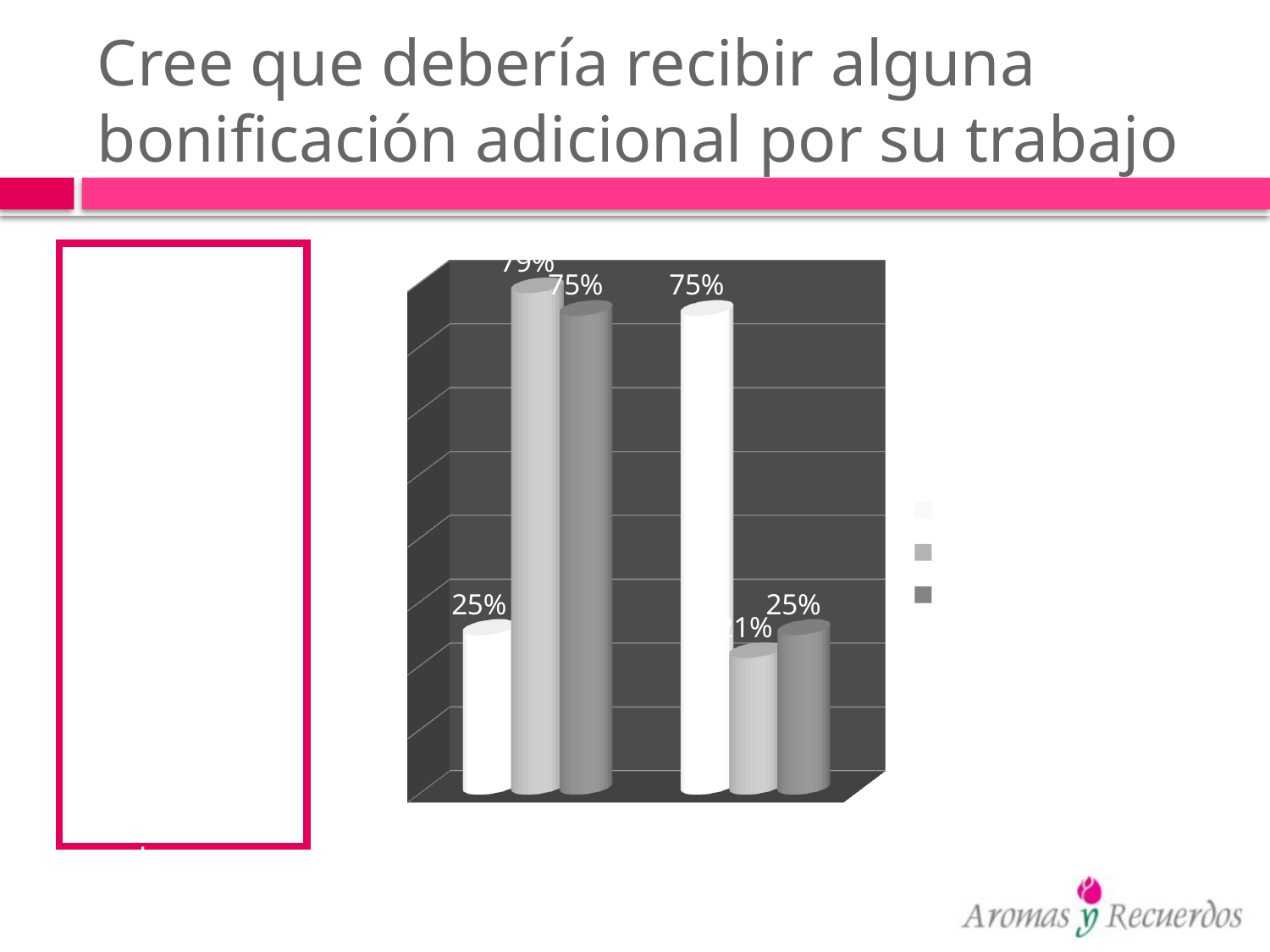
How many groups of bars does the chart show? 2 What is the value of the light gray bar in the left group of bars? 79% What is the value of the dark gray bar in the right group of bars? 25% In the right group, which is larger: the white bar or the dark gray bar? the white bar Which bar has the highest value in the chart? the light gray bar in the left group (79%) What kind of chart is shown on the slide? bar chart What is the value of the white bar in the right group of bars? 75% What is the title of the slide containing the chart? Cree que debería recibir alguna bonificación adicional por su trabajo How many series does the legend list? 3 What is the difference between the light gray bar and the white bar in the left group? 54% What is the value of the dark gray bar in the left group of bars? 75% What is the value of the white bar in the left group of bars? 25%